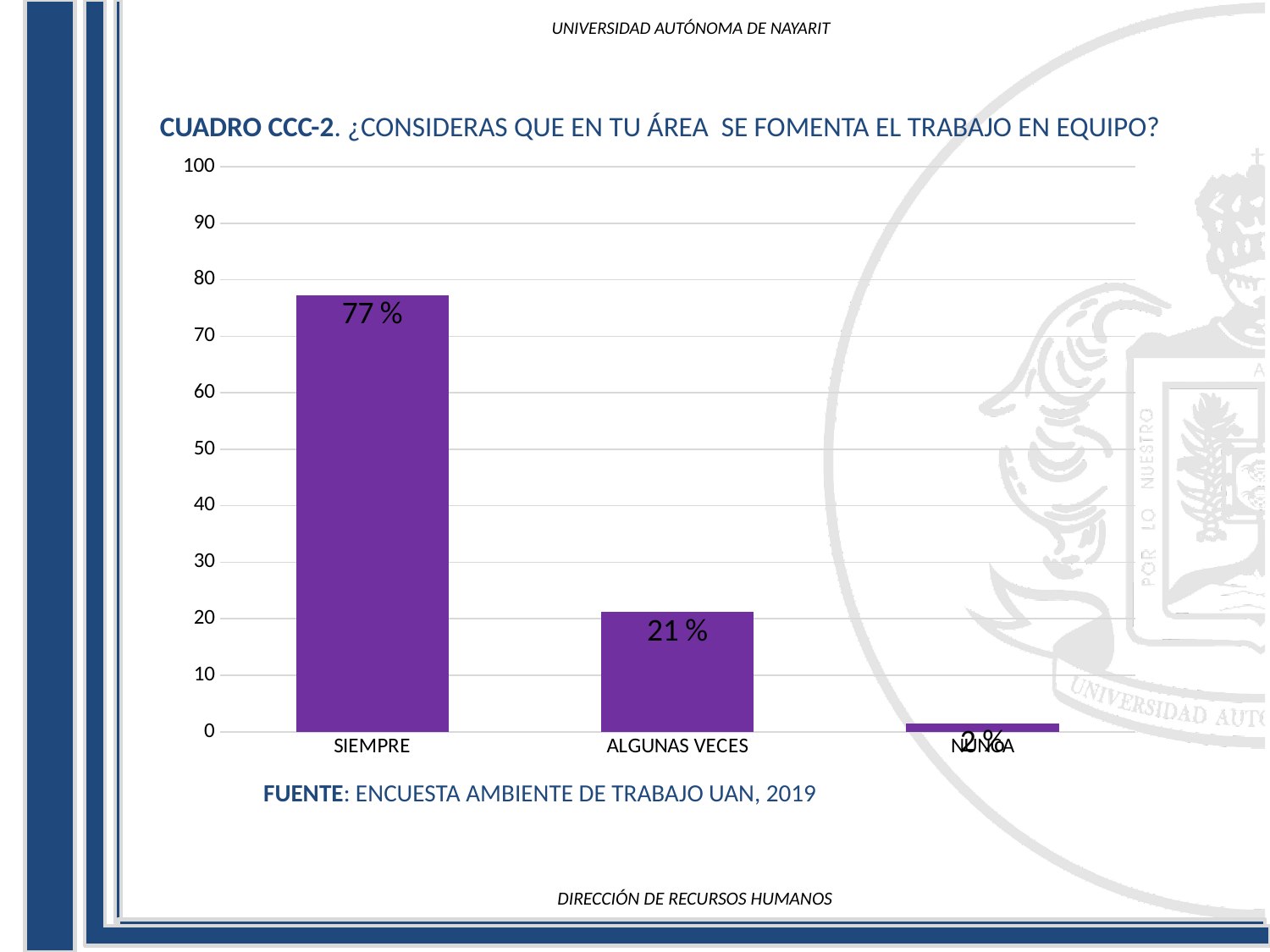
Do the values rise or fall from left to right along the x axis? fall Which is larger, the value for ALGUNAS VECES or the value for NUNCA? ALGUNAS VECES What is the value for SIEMPRE? 77 % What is the value for ALGUNAS VECES? 21 % What is the source cited below the chart? ENCUESTA AMBIENTE DE TRABAJO UAN, 2019 Which category has the highest value? SIEMPRE Is the value for NUNCA greater or less than 10? less What type of chart is shown on the slide? bar chart What is the difference between the values for SIEMPRE and ALGUNAS VECES? 56 % Is the value for SIEMPRE greater or less than 70? greater How many categories are shown on the x axis? 3 Which category has the lowest value? NUNCA